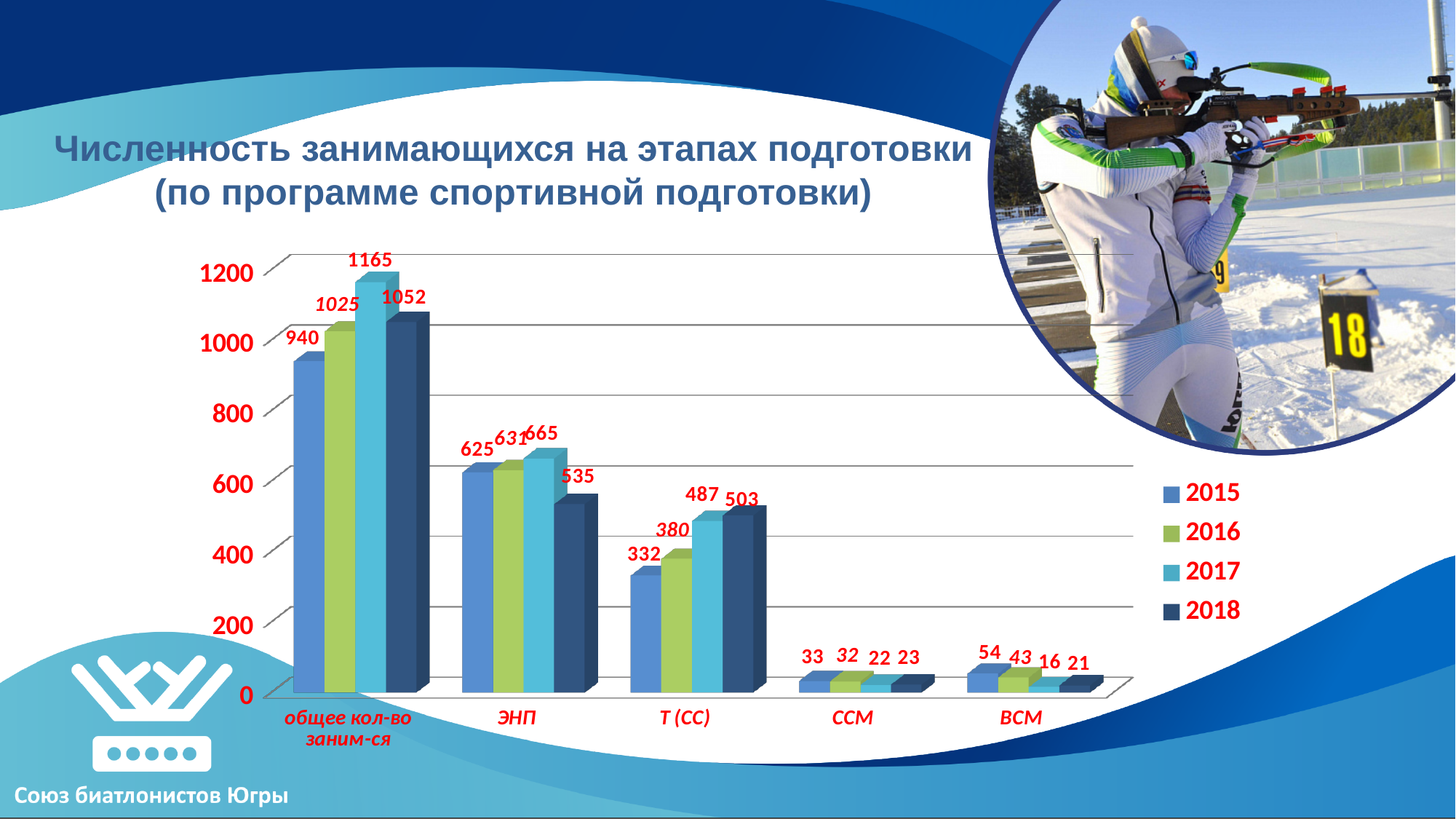
What is the value for 2017 in the category 'общее кол-во заним-ся'? 1165 What is the title of the chart? Численность занимающихся на этапах подготовки (по программе спортивной подготовки) How many categories are shown on the x axis? 5 What is the value for 2018 in the category 'ЭНП'? 535 What type of chart is shown on the slide? bar chart Which is larger in the category 'ССМ': the value for 2015 or the value for 2016? 2015 Which year has the highest value in the category 'общее кол-во заним-ся'? 2017 What is the difference between the 2018 and 2015 values in the category 'Т (СС)'? 171 What is the value for 2015 in the category 'Т (СС)'? 332 How many series does the legend list? 4 Do the values for 'Т (СС)' rise or fall from 2015 to 2018? rise Which year has the lowest value in the category 'ВСМ'? 2017